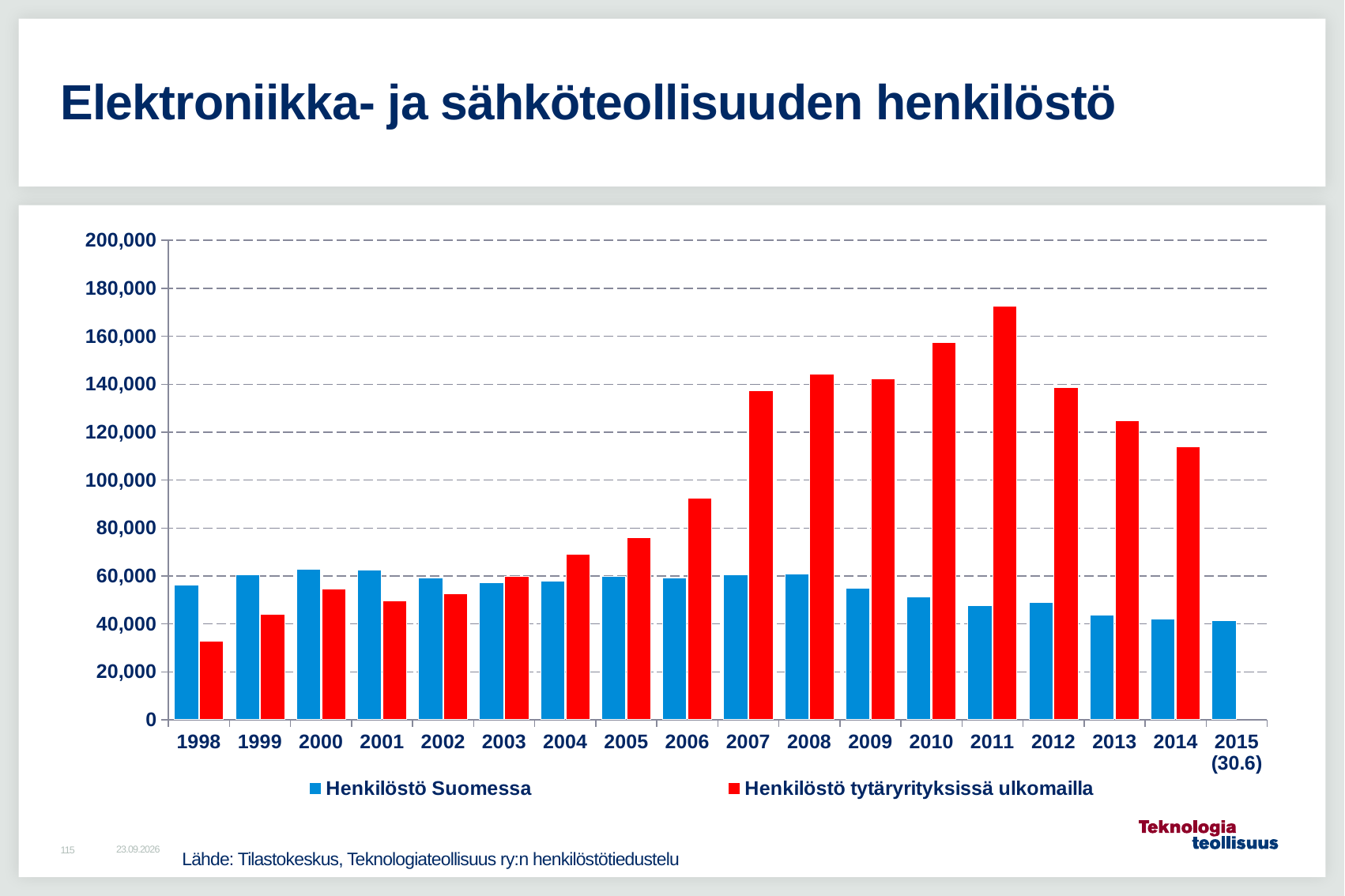
What kind of chart is shown on the slide? bar chart In 2007, which is larger: Henkilöstö Suomessa or Henkilöstö tytäryrityksissä ulkomailla? Henkilöstö tytäryrityksissä ulkomailla Is the value for Henkilöstö tytäryrityksissä ulkomailla in 1998 greater or less than 40,000? less In which year is the value for Henkilöstö tytäryrityksissä ulkomailla highest? 2011 How many series does the legend list? 2 Is the value for Henkilöstö tytäryrityksissä ulkomailla in 2011 greater or less than 160,000? greater Is the value for Henkilöstö tytäryrityksissä ulkomailla in 2006 greater or less than 80,000? greater Does the value for Henkilöstö Suomessa rise or fall from 2008 to 2015 (30.6)? fall In 1998, which is larger: Henkilöstö Suomessa or Henkilöstö tytäryrityksissä ulkomailla? Henkilöstö Suomessa How many years are shown on the x axis? 18 In which year is the value for Henkilöstö tytäryrityksissä ulkomailla lowest? 1998